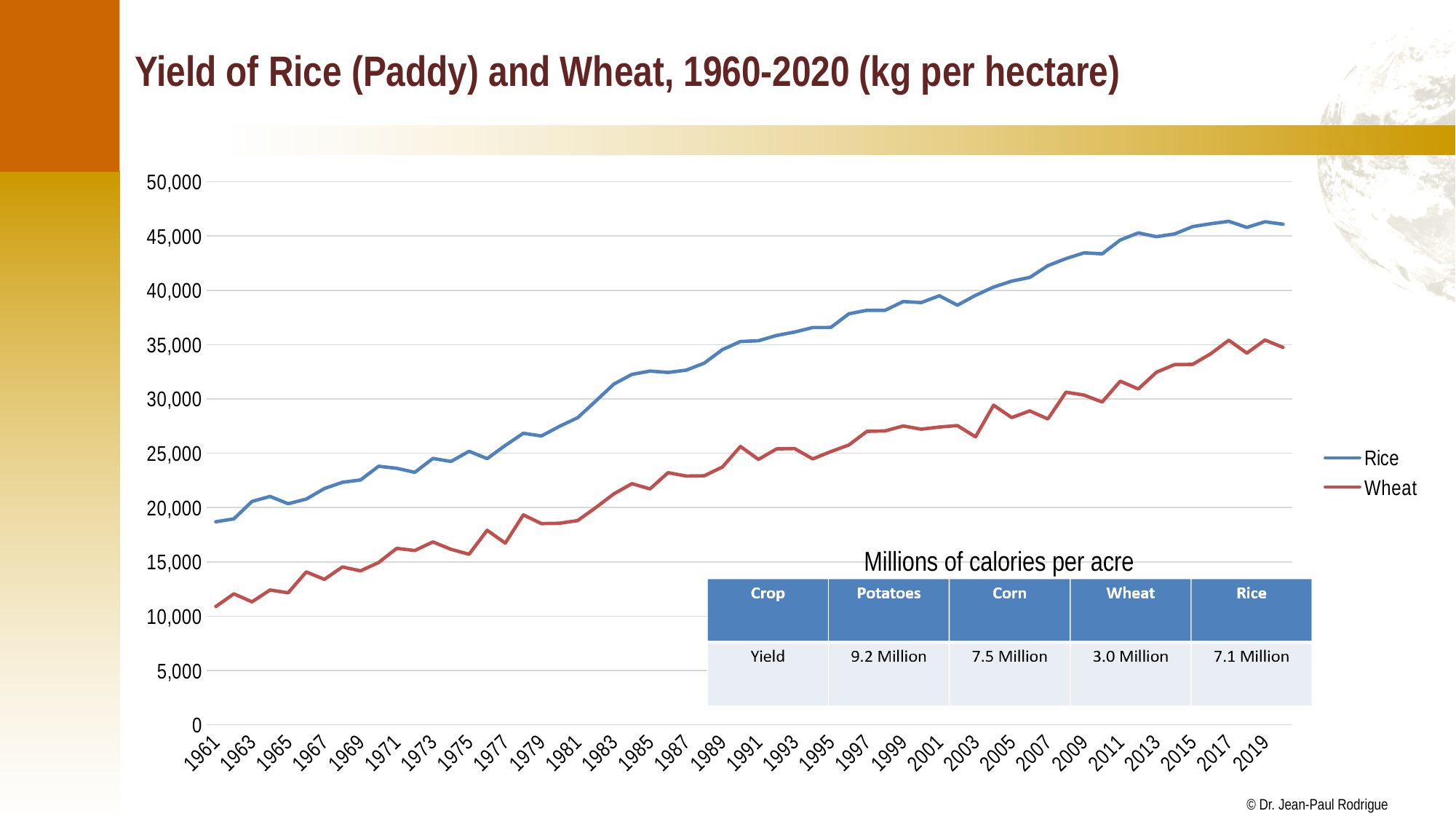
Is the value for Wheat in 1981 greater or less than 20,000? less Do the Rice yield values generally rise or fall from 1961 to 2019? rise Is the value for Wheat in 2003 greater or less than 25,000? greater Which series has the higher yield in 2019, Rice or Wheat? Rice How many series does the chart's legend list? 2 Which series is plotted with the blue line? Rice Is the value for Rice in 1961 greater or less than 20,000? less What kind of chart is shown on the slide? line chart Which series has the lowest value on the chart? Wheat Which series reaches the highest value on the chart? Rice Which two series are listed in the chart's legend? Rice and Wheat